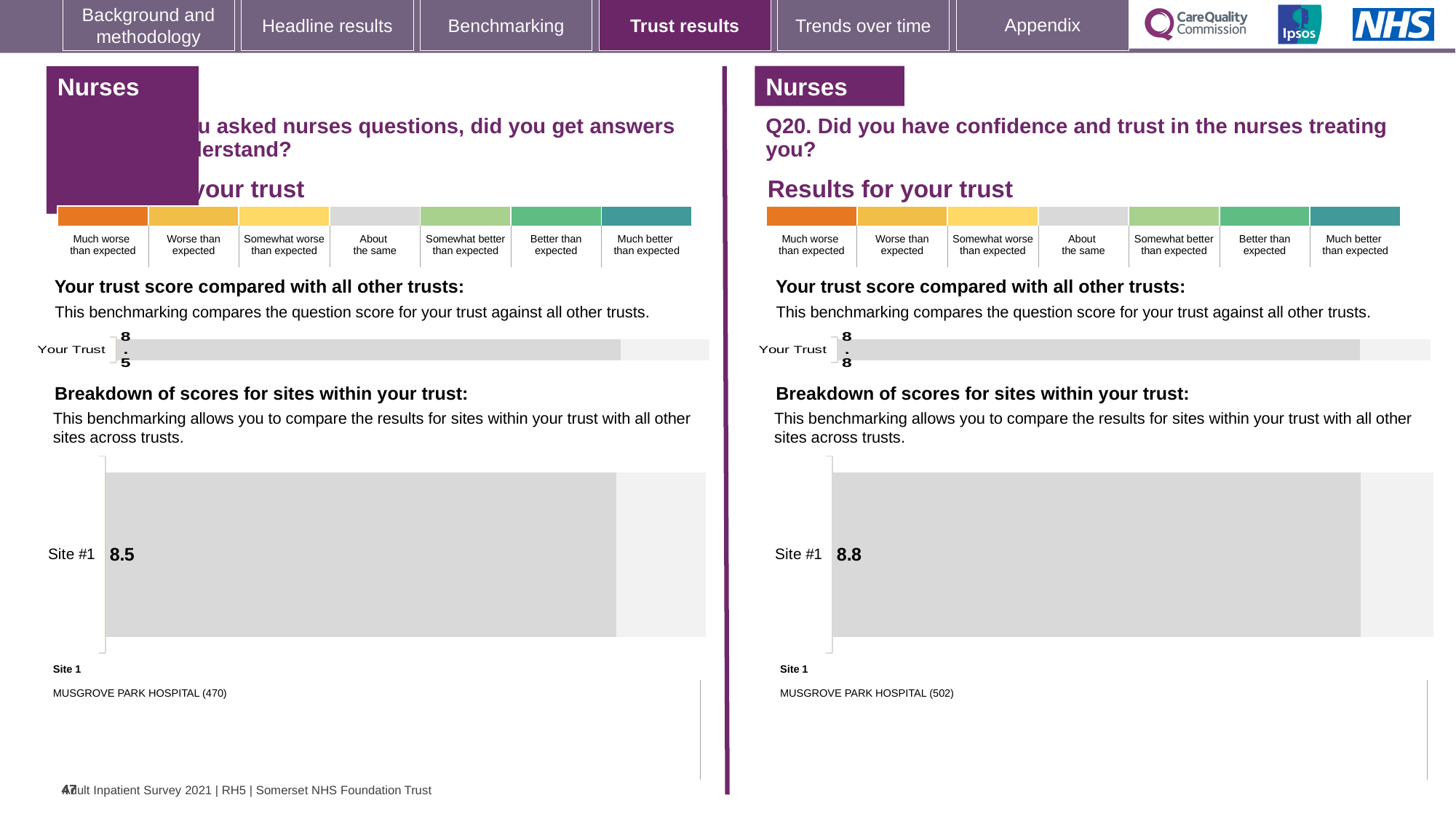
On the left half of the slide, what is the score shown for Your Trust? 8.5 On the right half of the slide (Q20), is the Your Trust score the same as the Site #1 score? Yes, both 8.8 How many sites are shown in the breakdown of scores chart on the right half of the slide (Q20)? 1 Which is larger: the Your Trust score on the left half of the slide or the Your Trust score on the right half (Q20)? Right half (Q20), 8.8 What type of chart is used to show the Site #1 score on the left half of the slide? Bar chart On the left half of the slide, which site is listed as Site 1 below the breakdown chart? MUSGROVE PARK HOSPITAL (470) On the right half of the slide (Q20), which site is listed as Site 1 below the breakdown chart? MUSGROVE PARK HOSPITAL (502) On the left half of the slide, what is the score shown for Site #1 in the breakdown of scores for sites within your trust? 8.5 On the right half of the slide (Q20, confidence and trust in nurses), what is the score shown for Your Trust? 8.8 On the right half of the slide (Q20), what is the score shown for Site #1 in the breakdown of scores for sites within your trust? 8.8 What is the difference between the Site #1 score on the right half of the slide (Q20) and the Site #1 score on the left half? 0.3